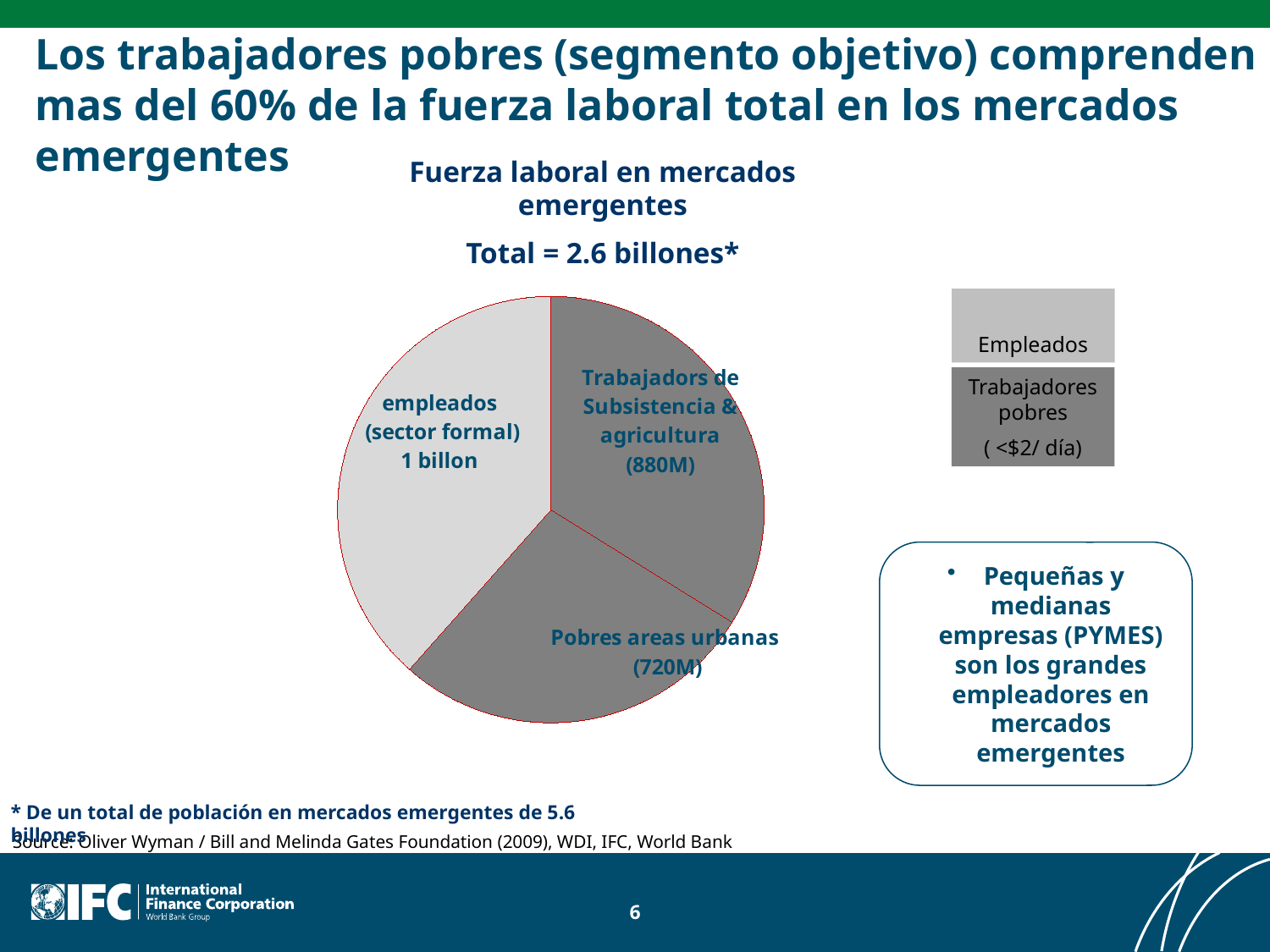
What is the value shown for the 'empleados (sector formal)' slice? 1 billon What is the value shown for the 'Trabajadors de Subsistencia & agricultura' slice? 880M What kind of chart is shown on the slide? pie chart How many entries does the legend next to the pie chart list? 2 Which slice of the pie chart is the smallest? Pobres areas urbanas How many slices does the pie chart have? 3 Which slice of the pie chart is the largest? empleados (sector formal) What total is stated for the pie chart? 2.6 billones* What is the title of the pie chart? Fuerza laboral en mercados emergentes What is the value shown for the 'Pobres areas urbanas' slice? 720M What is the difference between the 'Trabajadors de Subsistencia & agricultura' slice and the 'Pobres areas urbanas' slice? 160M Which is larger, 'Trabajadors de Subsistencia & agricultura' or 'Pobres areas urbanas'? Trabajadors de Subsistencia & agricultura